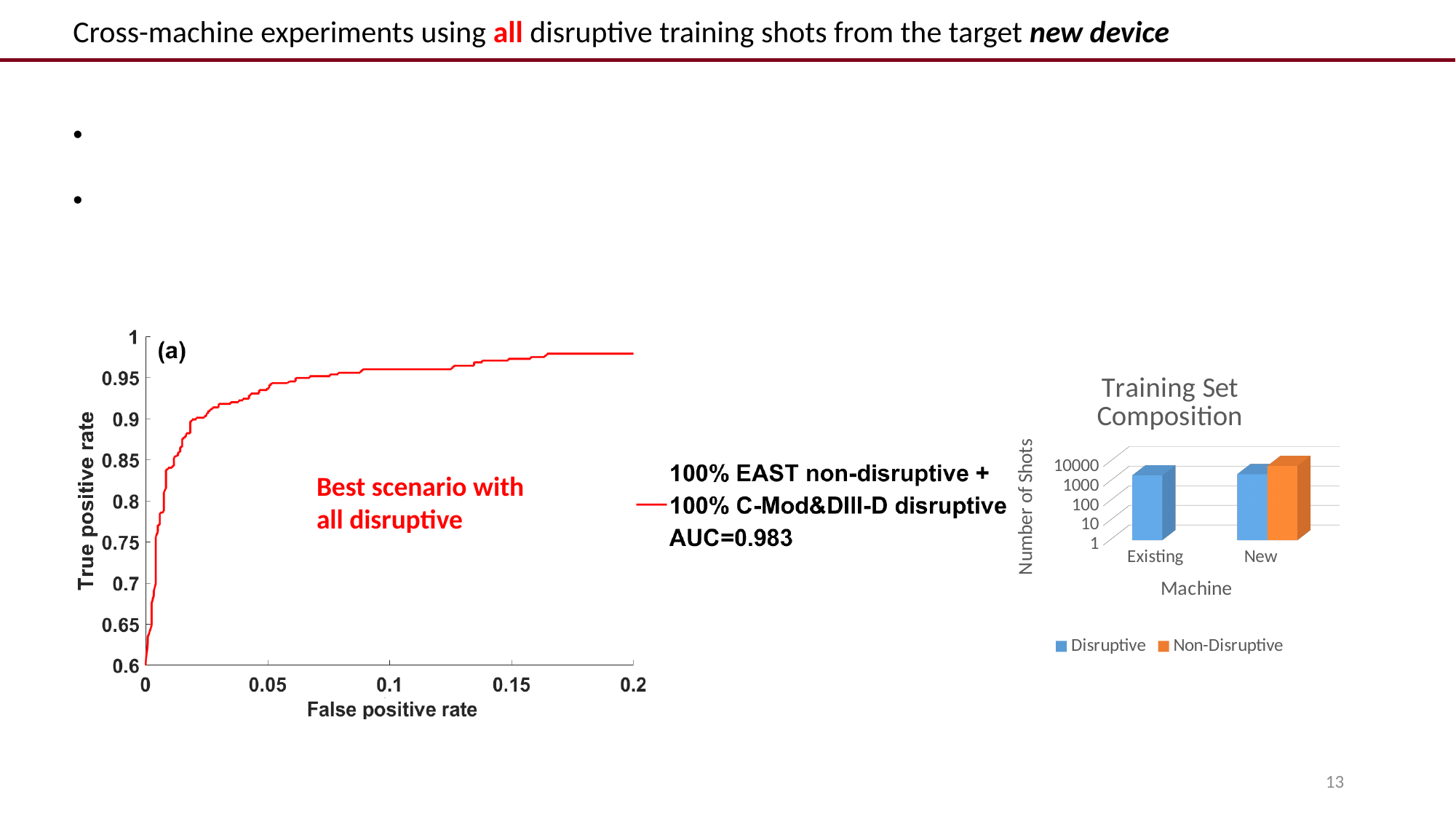
In the 'Training Set Composition' chart, how many machine categories are shown on the x axis? 2 In the 'Training Set Composition' chart, which machine category has a Non-Disruptive bar? New What kind of chart is the 'Training Set Composition' chart on the right of the slide? bar chart In the 'Training Set Composition' chart, how many series does the legend list? 2 In the 'Training Set Composition' chart, what are the two series named in the legend? Disruptive and Non-Disruptive In the 'Training Set Composition' chart, is the Non-Disruptive value for New greater or less than 1000? greater What kind of chart is the chart on the left with 'False positive rate' on the x axis? line chart In the ROC chart on the left, what AUC value is given in the legend? AUC=0.983 In the 'Training Set Composition' chart, is the Disruptive value for Existing greater or less than 100? greater In the 'Training Set Composition' chart, what is the label of the y axis? Number of Shots In the 'Training Set Composition' chart, for the New machine, which series has the larger value, Disruptive or Non-Disruptive? Non-Disruptive In the ROC chart on the left, does the true positive rate rise or fall as the false positive rate increases from 0 to 0.2? rise